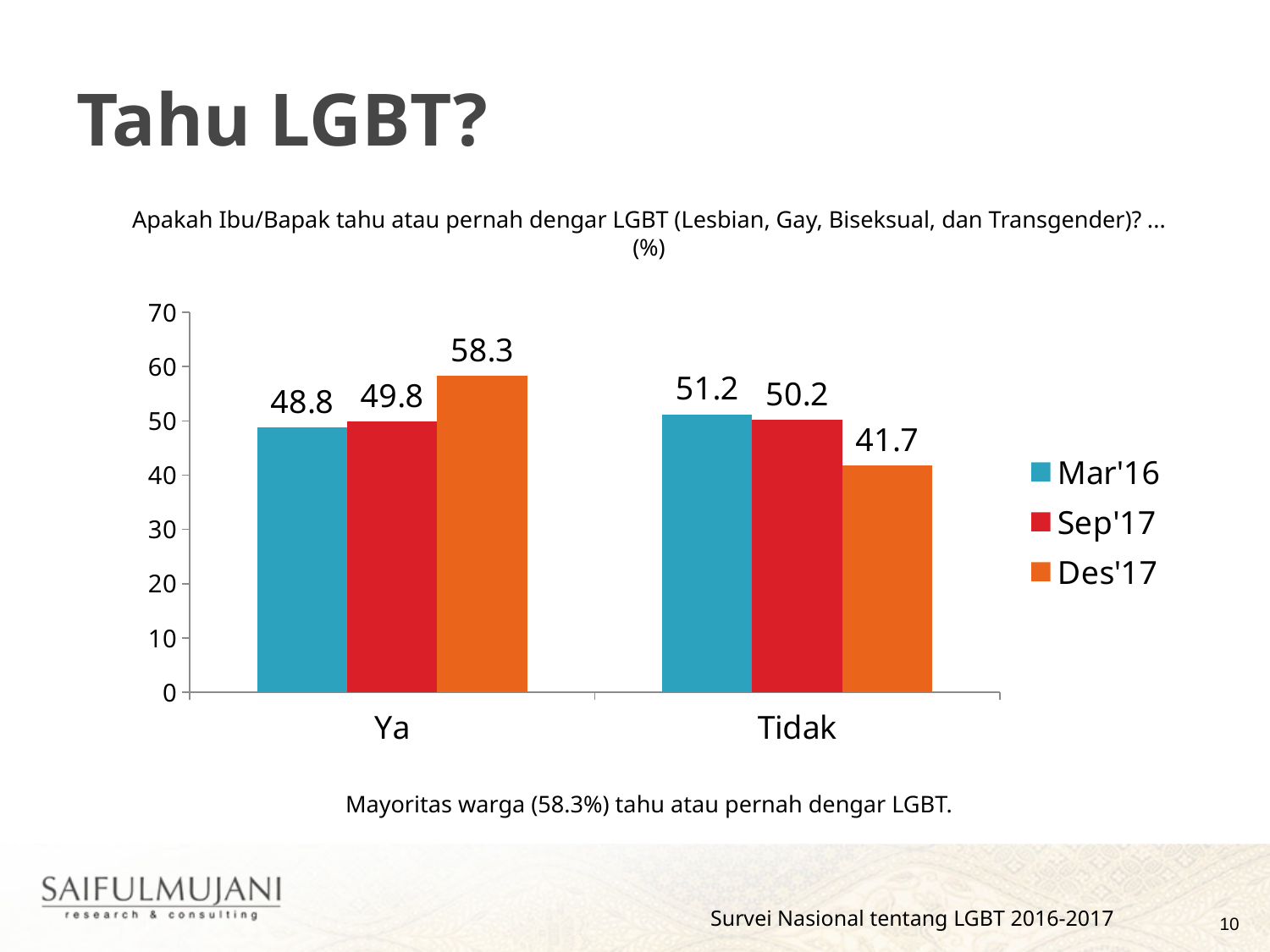
How many series does the legend list? 3 Which is larger in the Mar'16 series, Ya or Tidak? Tidak Is the value for Ya in the Mar'16 series greater or less than 50? less What is the value for Ya in the Sep'17 series? 49.8 What is the difference between the Des'17 values for Ya and Tidak? 16.6 What kind of chart is shown on the slide? bar chart What is the value for Ya in the Des'17 series? 58.3 What is the value for Tidak in the Des'17 series? 41.7 Which series has the highest value for Ya? Des'17 What colour are the Sep'17 bars? red What is the value for Tidak in the Mar'16 series? 51.2 Which series has the lowest value for Tidak? Des'17